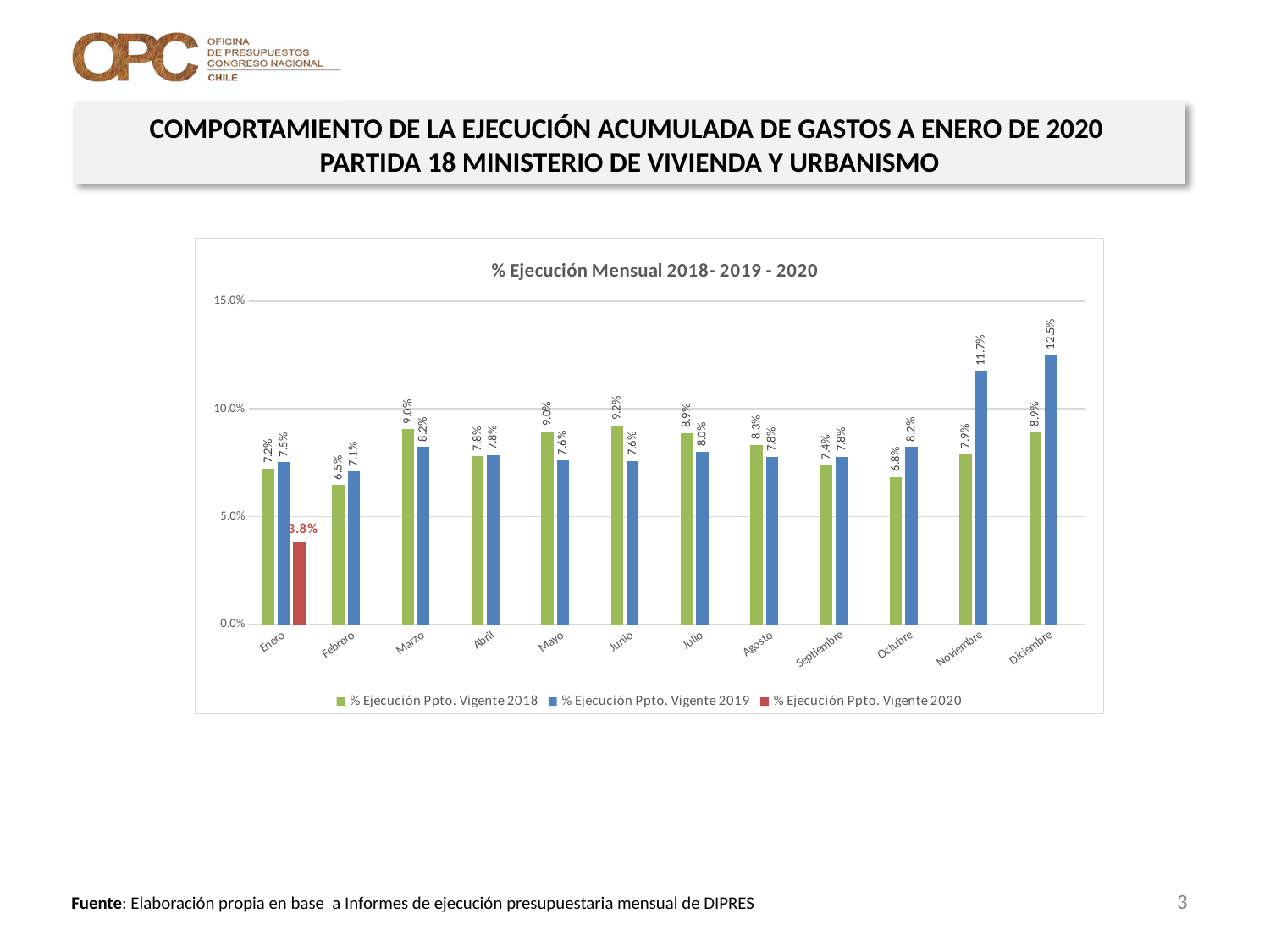
How many months are shown on the x axis? 12 Which month has the highest value for % Ejecución Ppto. Vigente 2019? Diciembre What is the value for % Ejecución Ppto. Vigente 2019 in Diciembre? 12.5% What is the value for % Ejecución Ppto. Vigente 2018 in Junio? 9.2% What is the title of the chart? % Ejecución Mensual 2018- 2019 - 2020 How many series does the legend list? 3 What is the value for % Ejecución Ppto. Vigente 2019 in Noviembre? 11.7% What is the value for % Ejecución Ppto. Vigente 2020 in Enero? 3.8% What kind of chart is shown on the slide? Bar chart In Marzo, which series is larger: % Ejecución Ppto. Vigente 2018 or % Ejecución Ppto. Vigente 2019? % Ejecución Ppto. Vigente 2018 Which month has the lowest value for % Ejecución Ppto. Vigente 2018? Febrero What is the difference between the 2019 and 2018 values in Diciembre? 3.6%